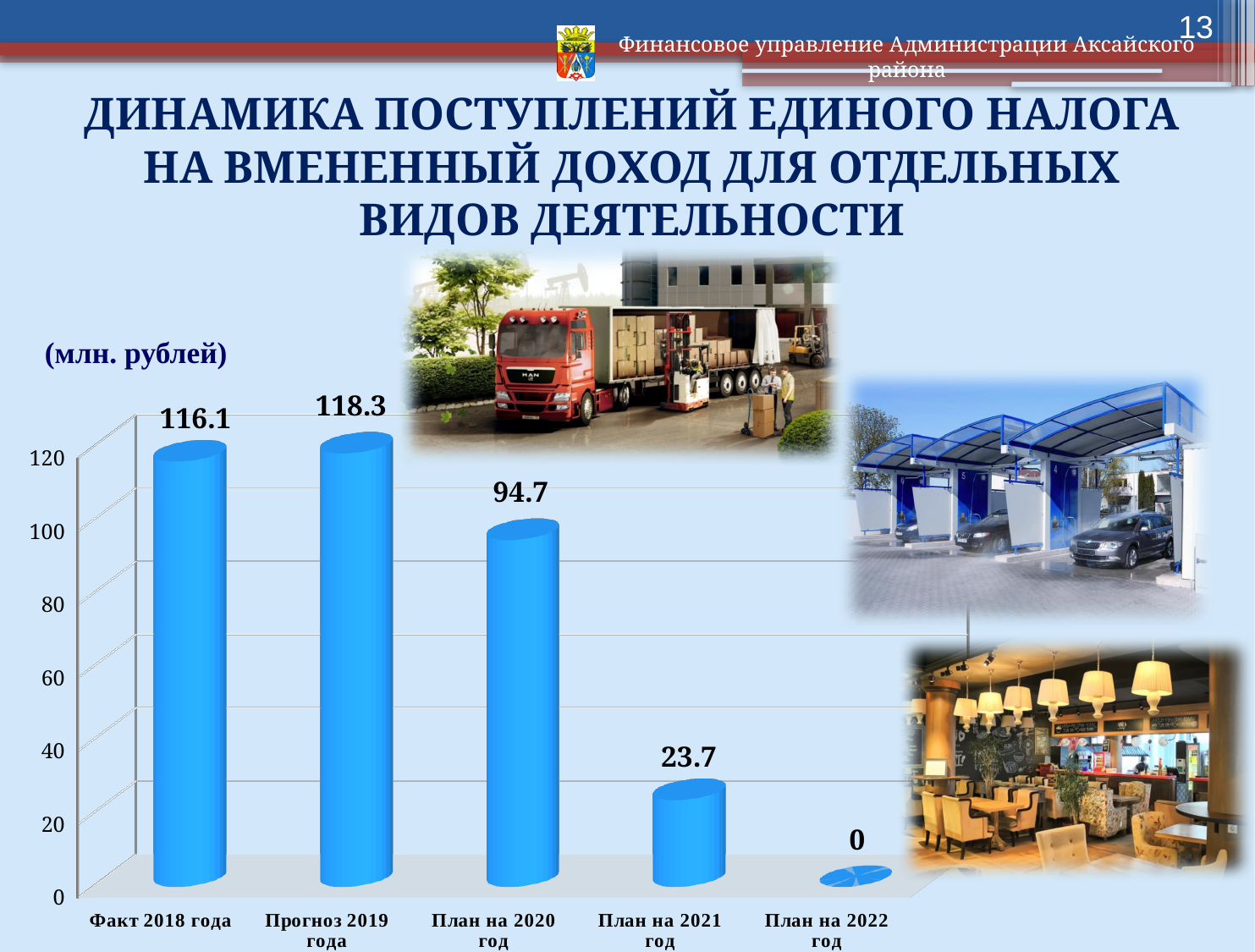
Which category has the highest value? Прогноз 2019 года What is the value for Факт 2018 года? 116.1 What is the difference between the values for Прогноз 2019 года and Факт 2018 года? 2.2 What is the value for План на 2020 год? 94.7 What is the value for План на 2022 год? 0 What is the value for Прогноз 2019 года? 118.3 Which category has the lowest value? План на 2022 год What is the value for План на 2021 год? 23.7 What is the difference between the values for План на 2020 год and План на 2021 год? 71 How many categories are shown on the x axis? 5 Which is larger, the value for План на 2020 год or the value for План на 2021 год? План на 2020 год What kind of chart is shown on the slide? Bar chart